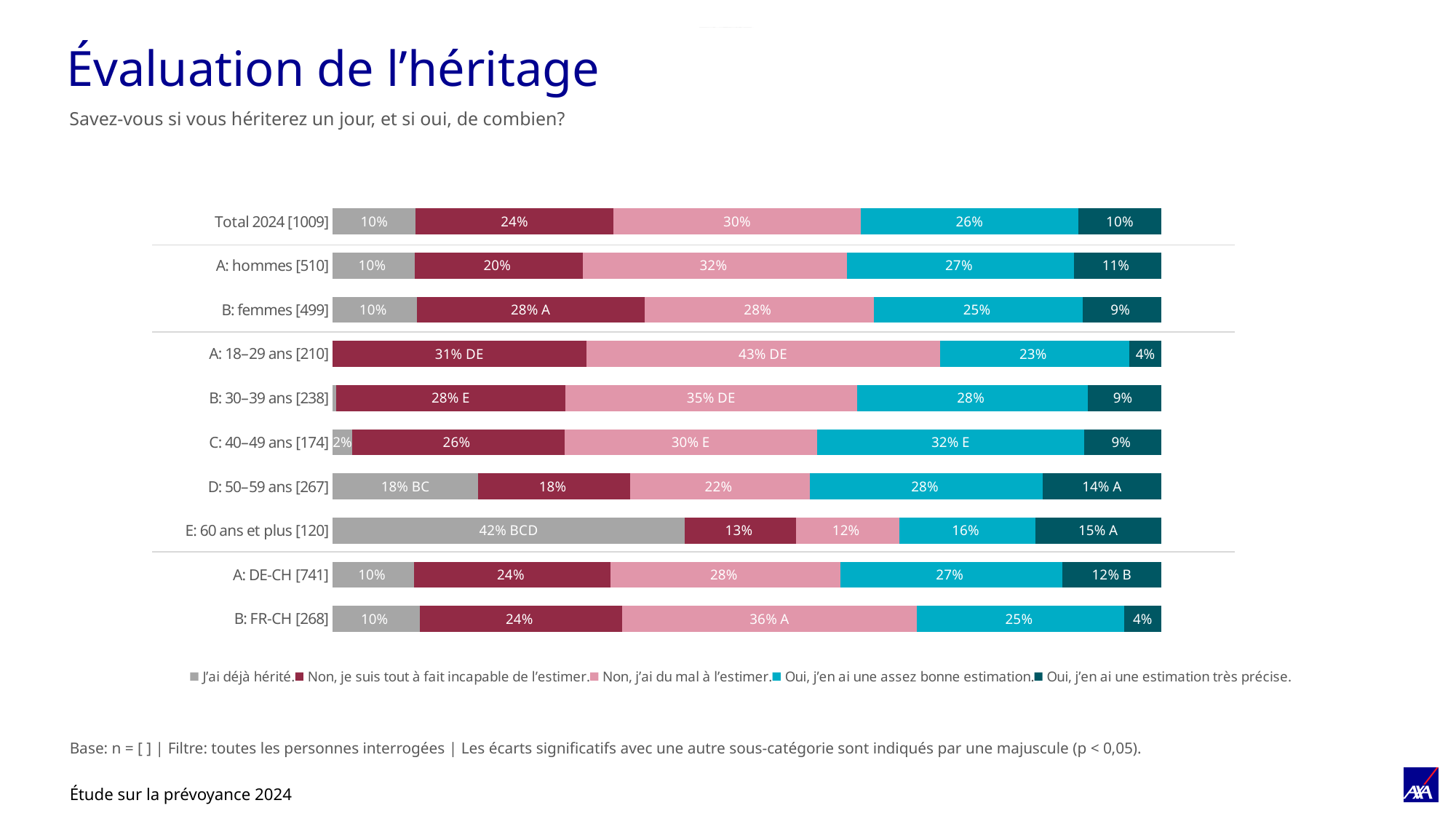
What is the value for "J'ai déjà hérité" in the E: 60 ans et plus [120] bar? 42% What is the value for "Non, j'ai du mal à l'estimer" in the Total 2024 [1009] bar? 30% In the Total 2024 [1009] bar, what is the difference between "Oui, j'en ai une assez bonne estimation" and "Non, je suis tout à fait incapable de l'estimer"? 2 percentage points What survey question is shown under the slide title? Savez-vous si vous hériterez un jour, et si oui, de combien? How many categories (bars) are plotted in the chart? 10 Which category has the highest value for "J'ai déjà hérité"? E: 60 ans et plus [120] What is the value for "Oui, j'en ai une estimation très précise" in the A: 18–29 ans [210] bar? 4% How many series does the legend list? 5 What is the value for "Oui, j'en ai une assez bonne estimation" in the D: 50–59 ans [267] bar? 28% Which category has the highest value for "Non, j'ai du mal à l'estimer"? A: 18–29 ans [210] Which has the larger value for "Non, je suis tout à fait incapable de l'estimer": A: hommes [510] or B: femmes [499]? B: femmes [499] What kind of chart is shown on the slide? Stacked bar chart